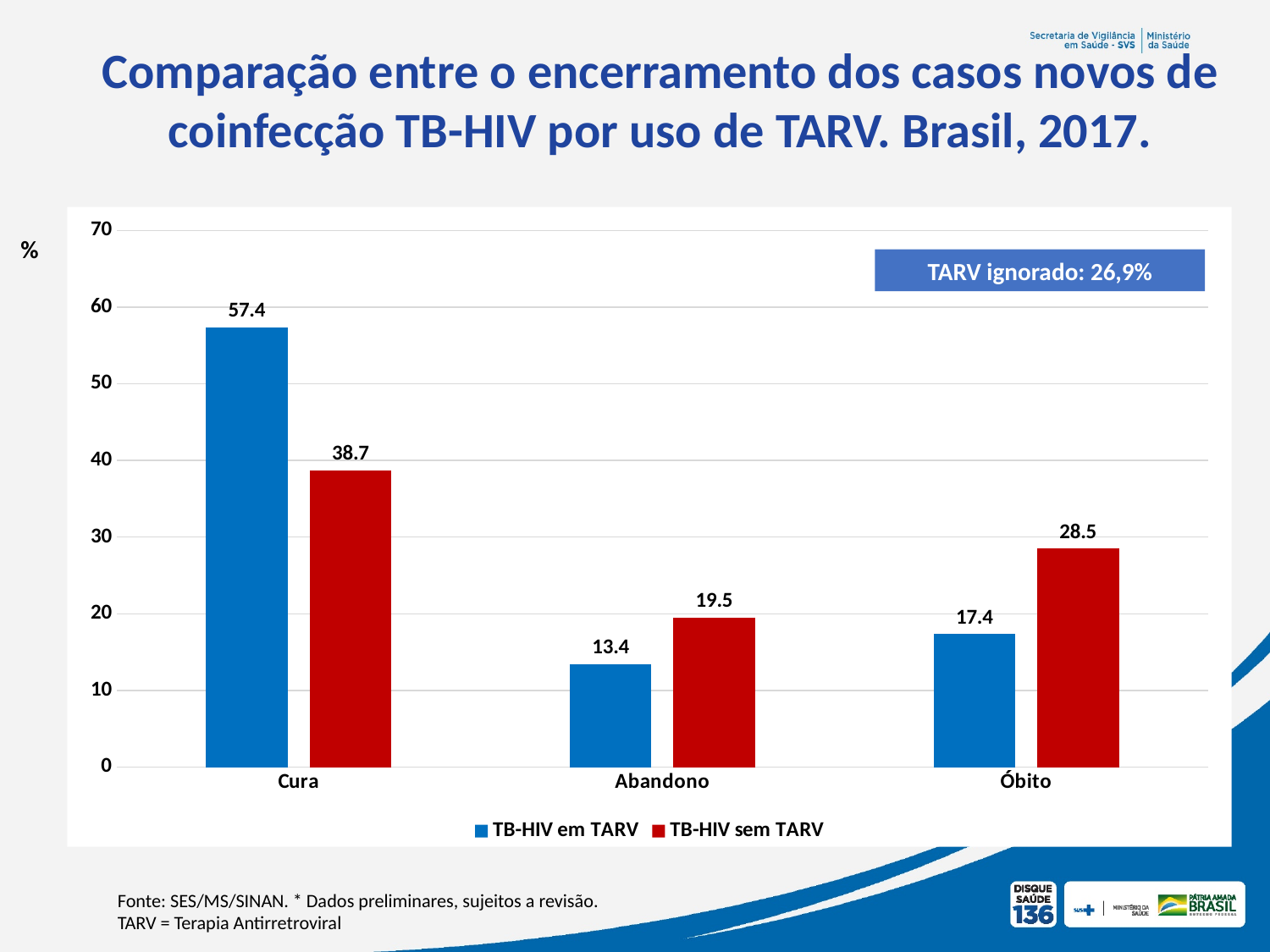
What kind of chart is shown on the slide? bar chart Which category has the lowest value for the TB-HIV sem TARV series? Abandono What is the value for TB-HIV sem TARV in the Óbito category? 28.5 What is the value for TB-HIV em TARV in the Cura category? 57.4 How many series does the legend list? 2 What is the difference between TB-HIV em TARV and TB-HIV sem TARV in the Cura category? 18.7 Which category has the highest value for the TB-HIV em TARV series? Cura What percentage is given for TARV ignorado in the box on the chart? 26,9% Is the value for TB-HIV em TARV in the Abandono category greater or less than 20? less In the Óbito category, which series has the larger value, TB-HIV em TARV or TB-HIV sem TARV? TB-HIV sem TARV How many categories are shown on the x axis? 3 What is the value for TB-HIV sem TARV in the Abandono category? 19.5